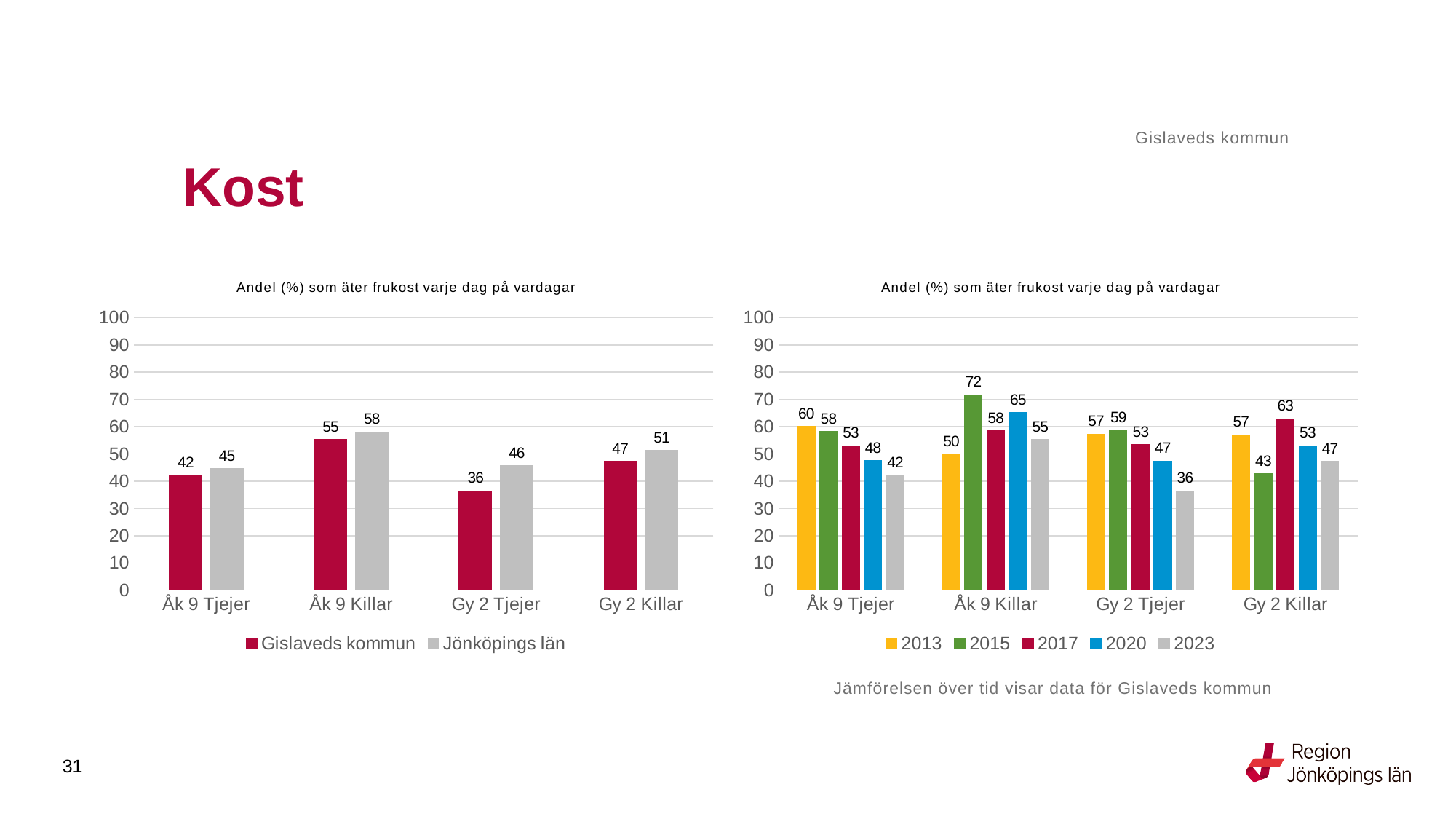
In the right chart, what is the value for 2023 for Gy 2 Killar? 47 In the right chart, is the value for 2013 for Åk 9 Tjejer larger or the value for 2020 for Åk 9 Tjejer? 2013 In the left chart, which category has the lowest value for Gislaveds kommun? Gy 2 Tjejer In the left chart, what is the value for Jönköpings län for Gy 2 Tjejer? 46 In the right chart, do the values for Gy 2 Tjejer rise or fall from 2015 to 2023? fall In the left chart, what is the difference between Jönköpings län and Gislaveds kommun for Gy 2 Tjejer? 10 What kind of chart is the left chart? bar chart In the left chart, how many series does the legend list? 2 In the right chart, how many series does the legend list? 5 In the right chart, what is the value for 2015 for Åk 9 Killar? 72 In the left chart, what is the value for Gislaveds kommun for Åk 9 Tjejer? 42 In the right chart, which year has the highest value for Gy 2 Killar? 2017